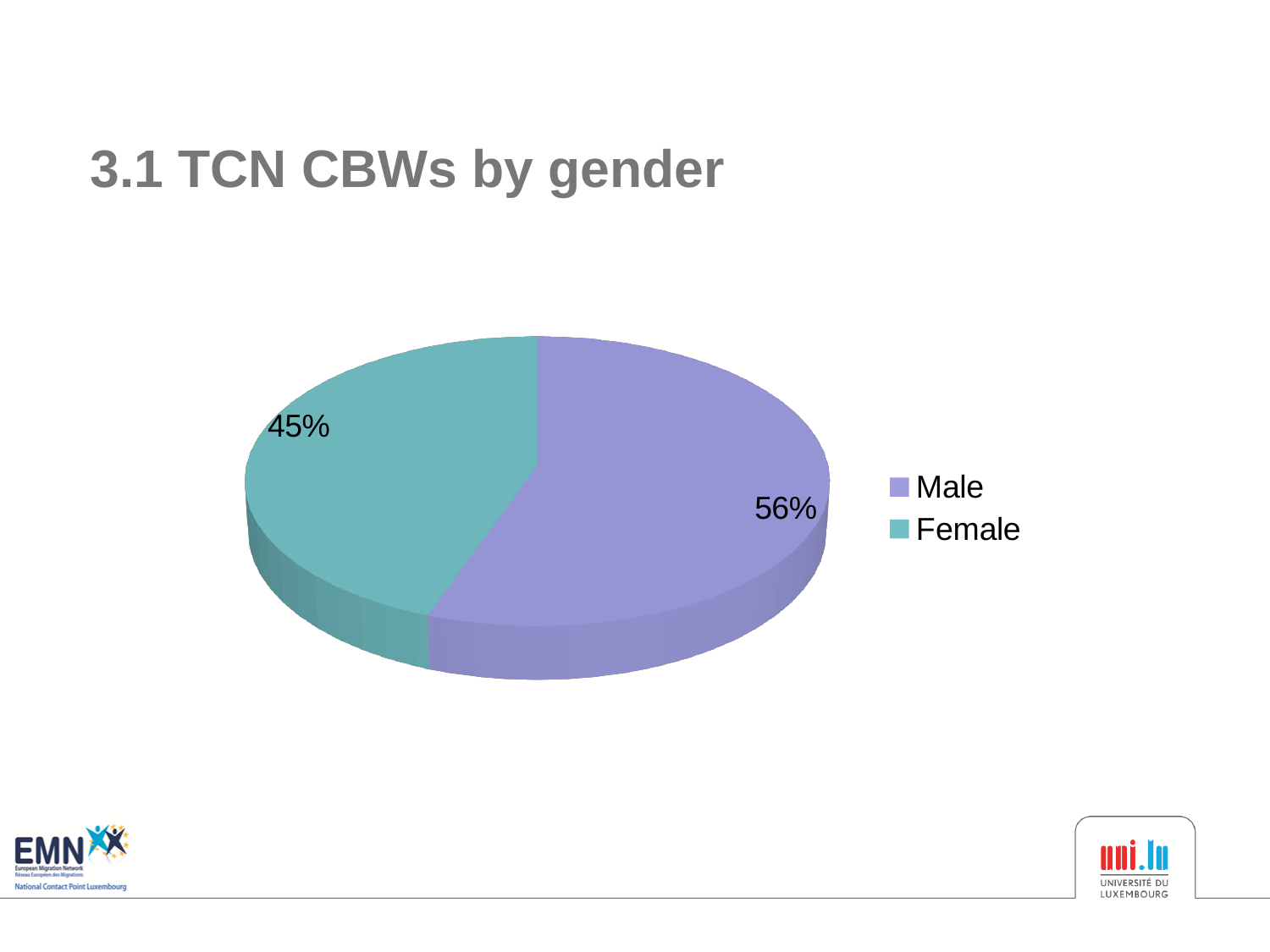
What percentage of TCN CBWs are male? 56% Which gender has the larger share of TCN CBWs? Male Is the share of male TCN CBWs larger or smaller than the share of female TCN CBWs? larger What is the difference in percentage points between the male and female shares? 11 What percentage of TCN CBWs are female? 45% What is the title of the slide? 3.1 TCN CBWs by gender What kind of chart is shown on the slide? pie chart Which gender has the smaller share of TCN CBWs? Female Which colour represents Female in the pie chart? teal How many categories does the pie chart show? 2 Is the share of male TCN CBWs greater or less than 50%? greater